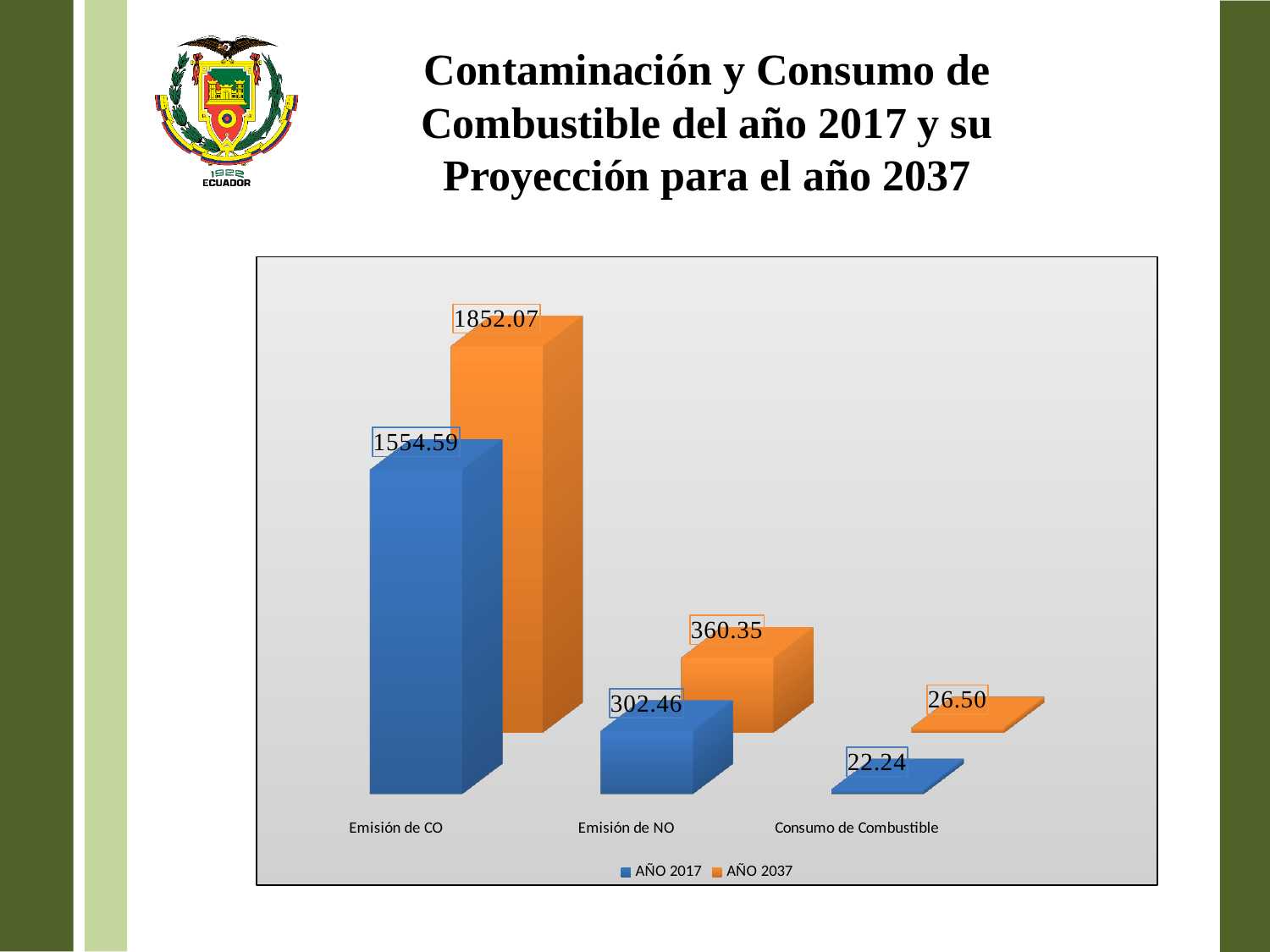
How many categories are shown on the x axis of the chart? 3 What is the difference between the AÑO 2037 and AÑO 2017 values for Emisión de CO? 297.48 Which is larger for Consumo de Combustible: the AÑO 2017 value or the AÑO 2037 value? AÑO 2037 Which category has the highest value in the AÑO 2037 series? Emisión de CO What is the value for Emisión de CO in the AÑO 2037 series? 1852.07 What is the value for Emisión de NO in the AÑO 2037 series? 360.35 What kind of chart is shown on the slide? Bar chart How many series does the legend list? 2 Which category has the lowest value in the AÑO 2017 series? Consumo de Combustible What is the difference between the AÑO 2037 and AÑO 2017 values for Emisión de NO? 57.89 What is the value for Consumo de Combustible in the AÑO 2017 series? 22.24 What is the value for Emisión de CO in the AÑO 2017 series? 1554.59